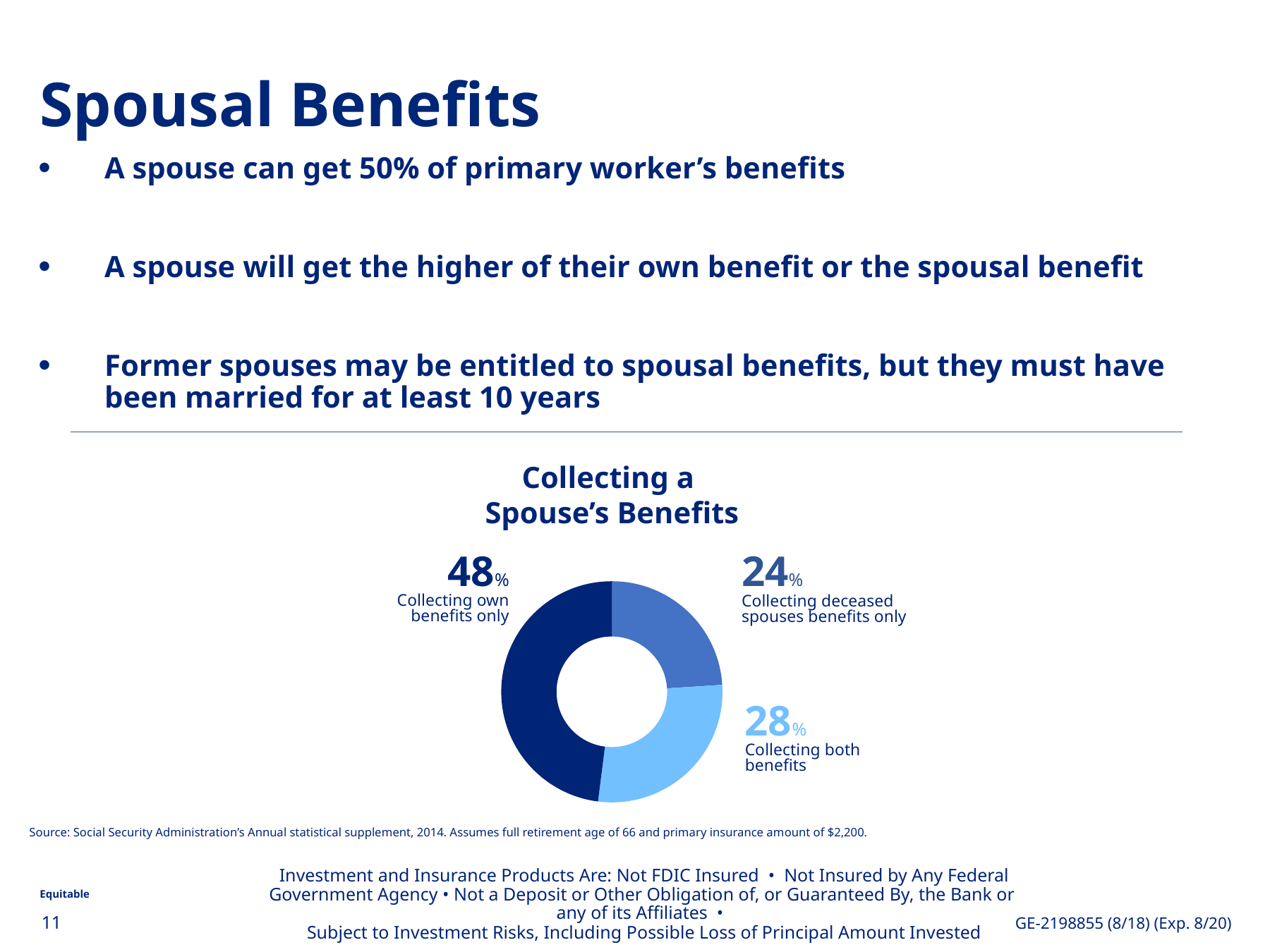
What percentage of the chart is for 'Collecting deceased spouses benefits only'? 24% Which is larger: the share for 'Collecting both benefits' or the share for 'Collecting deceased spouses benefits only'? Collecting both benefits What percentage of the chart is for 'Collecting both benefits'? 28% What percentage of the chart is for 'Collecting own benefits only'? 48% Which category has the largest share of the chart? Collecting own benefits only What kind of chart is shown on the slide? Doughnut chart What is the total of the three percentages shown in the chart? 100% What is the title of the chart? Collecting a Spouse's Benefits How many categories are shown in the chart? 3 Which category has the smallest share of the chart? Collecting deceased spouses benefits only What is the difference in percentage points between 'Collecting own benefits only' and 'Collecting both benefits'? 20 What is the difference in percentage points between 'Collecting both benefits' and 'Collecting deceased spouses benefits only'? 4